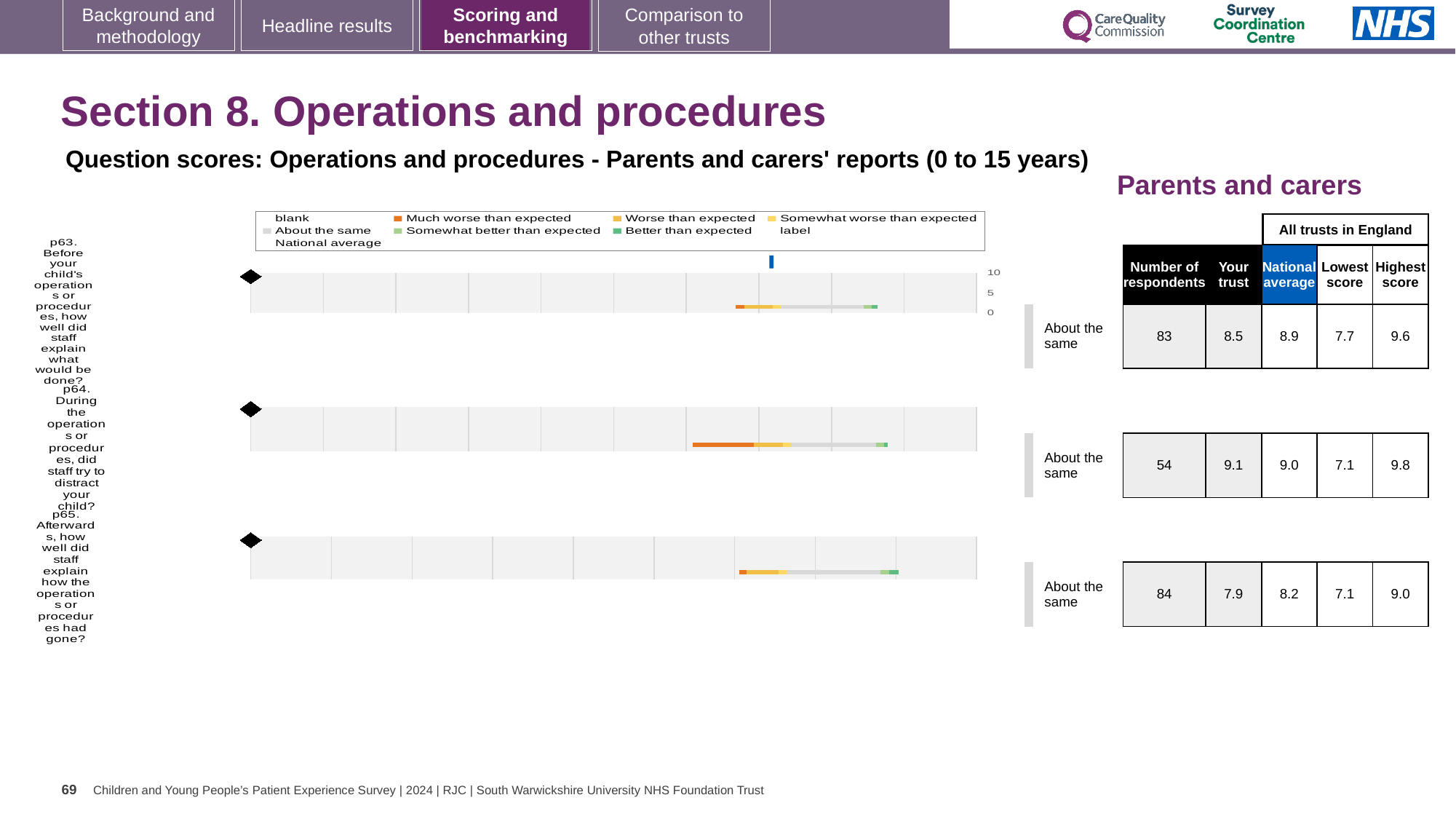
What is the 'Your trust' score for question p63 (Before your child's operations or procedures, how well did staff explain what would be done?)? 8.5 What is the title of the chart? Question scores: Operations and procedures - Parents and carers' reports (0 to 15 years) How many questions are plotted on the chart? 3 Which question has the lowest 'Your trust' score? p65 For question p65, how much higher is the national average than the 'Your trust' score? 0.3 For question p63, what is the difference between the highest score and the lowest score across all trusts in England? 1.9 How many respondents answered question p64 (During the operations or procedures, did staff try to distract your child?)? 54 What is the national average score for question p65 (Afterwards, how well did staff explain how the operations or procedures had gone?)? 8.2 What benchmark category is shown for all three questions? About the same For question p64, which is larger: the 'Your trust' score or the national average? Your trust Which question has the highest 'Your trust' score? p64 What is the highest score across all trusts in England for question p64? 9.8